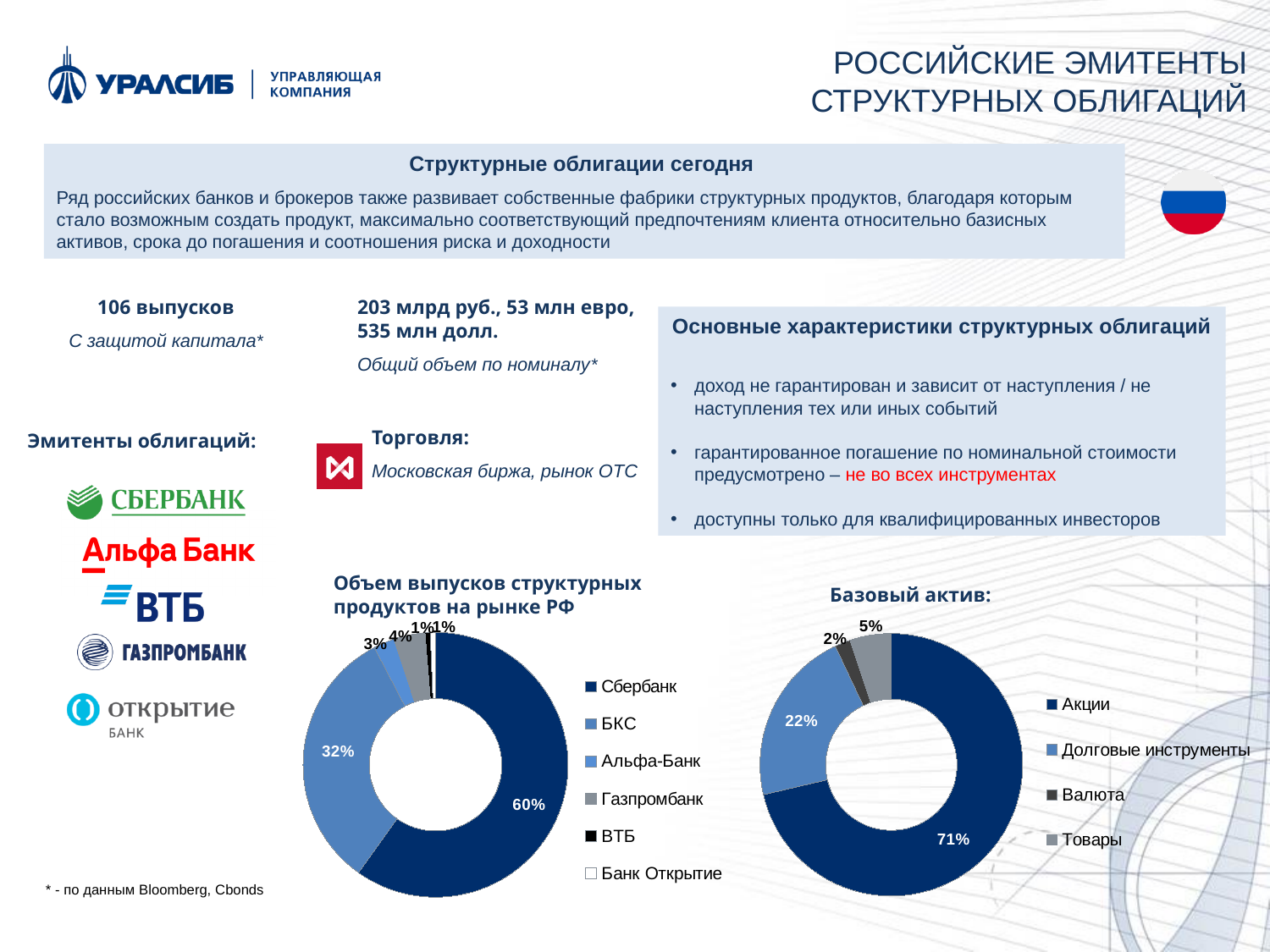
In the chart 'Объем выпусков структурных продуктов на рынке РФ', what share does Сбербанк have? 60% In the chart 'Базовый актив', what share do Акции have? 71% In the chart 'Объем выпусков структурных продуктов на рынке РФ', which issuer has the largest share? Сбербанк In the chart 'Объем выпусков структурных продуктов на рынке РФ', what is the difference between the shares of Сбербанк and БКС? 28 percentage points What type of chart is 'Объем выпусков структурных продуктов на рынке РФ'? Doughnut (pie) chart In the chart 'Базовый актив', what share do Товары have? 5% In the chart 'Объем выпусков структурных продуктов на рынке РФ', how many issuers are listed in the legend? 6 In the chart 'Объем выпусков структурных продуктов на рынке РФ', what share does БКС have? 32% In the chart 'Базовый актив', which is larger: Товары or Валюта? Товары In the chart 'Базовый актив', how many categories are shown in the legend? 4 In the chart 'Базовый актив', which category has the smallest share? Валюта In the chart 'Базовый актив', what share do Долговые инструменты have? 22%